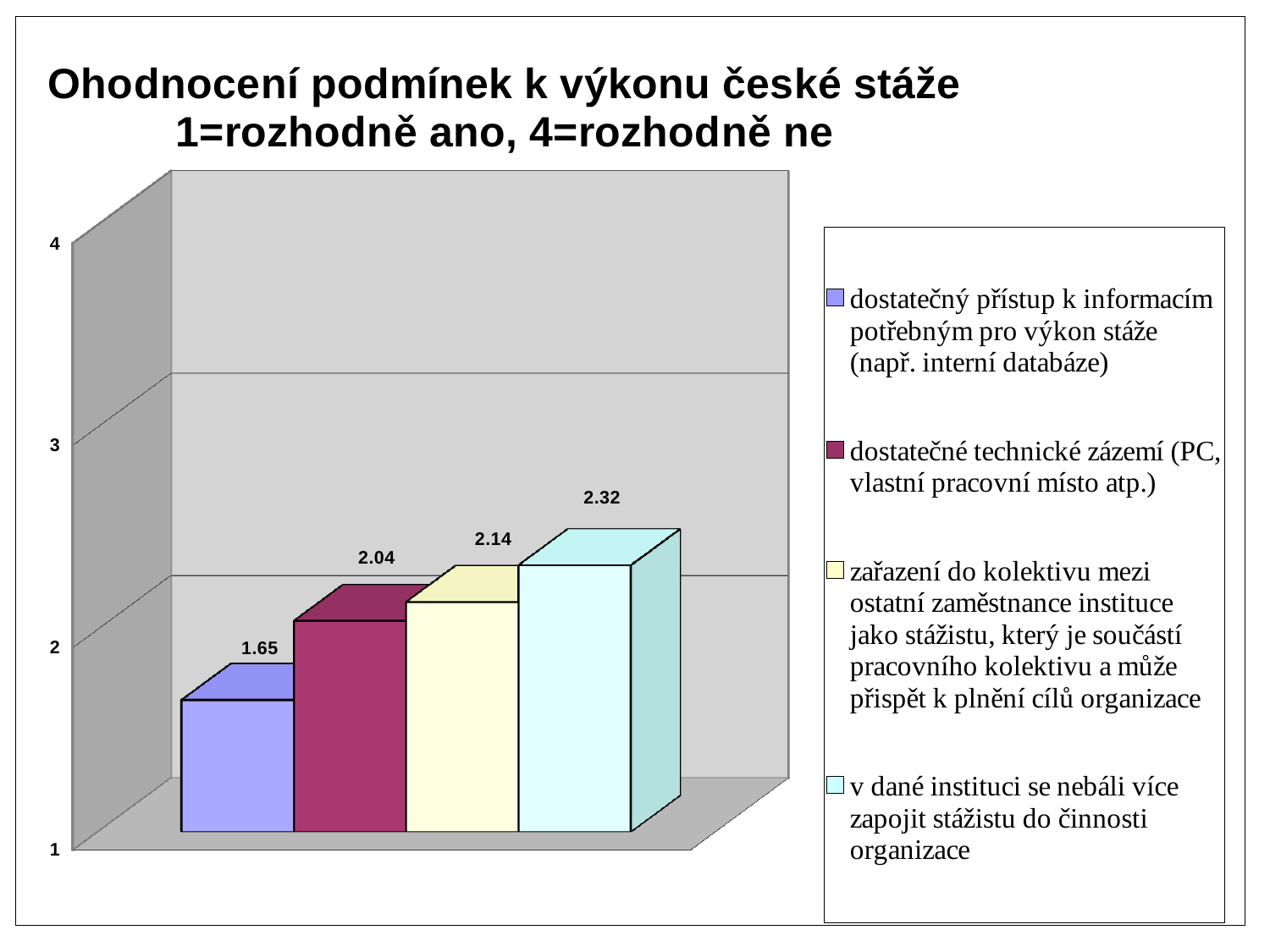
What is the value for "dostatečný přístup k informacím potřebným pro výkon stáže (např. interní databáze)"? 1.65 What kind of chart is shown on the slide? bar chart How many bars are plotted in the chart? 4 What is the difference between the highest value (2.32) and the lowest value (1.65)? 0.67 Which series has the highest value? v dané instituci se nebáli více zapojit stážistu do činnosti organizace What is the value for the series about "zařazení do kolektivu mezi ostatní zaměstnance instituce"? 2.14 How many series does the legend list? 4 What is the difference between the values for "dostatečné technické zázemí" and "dostatečný přístup k informacím"? 0.39 Which series has the lowest value? dostatečný přístup k informacím potřebným pro výkon stáže (např. interní databáze) What is the value for "dostatečné technické zázemí (PC, vlastní pracovní místo atp.)"? 2.04 Which is larger: the value for "dostatečné technické zázemí" or the value for "zařazení do kolektivu"? zařazení do kolektivu What is the value for "v dané instituci se nebáli více zapojit stážistu do činnosti organizace"? 2.32